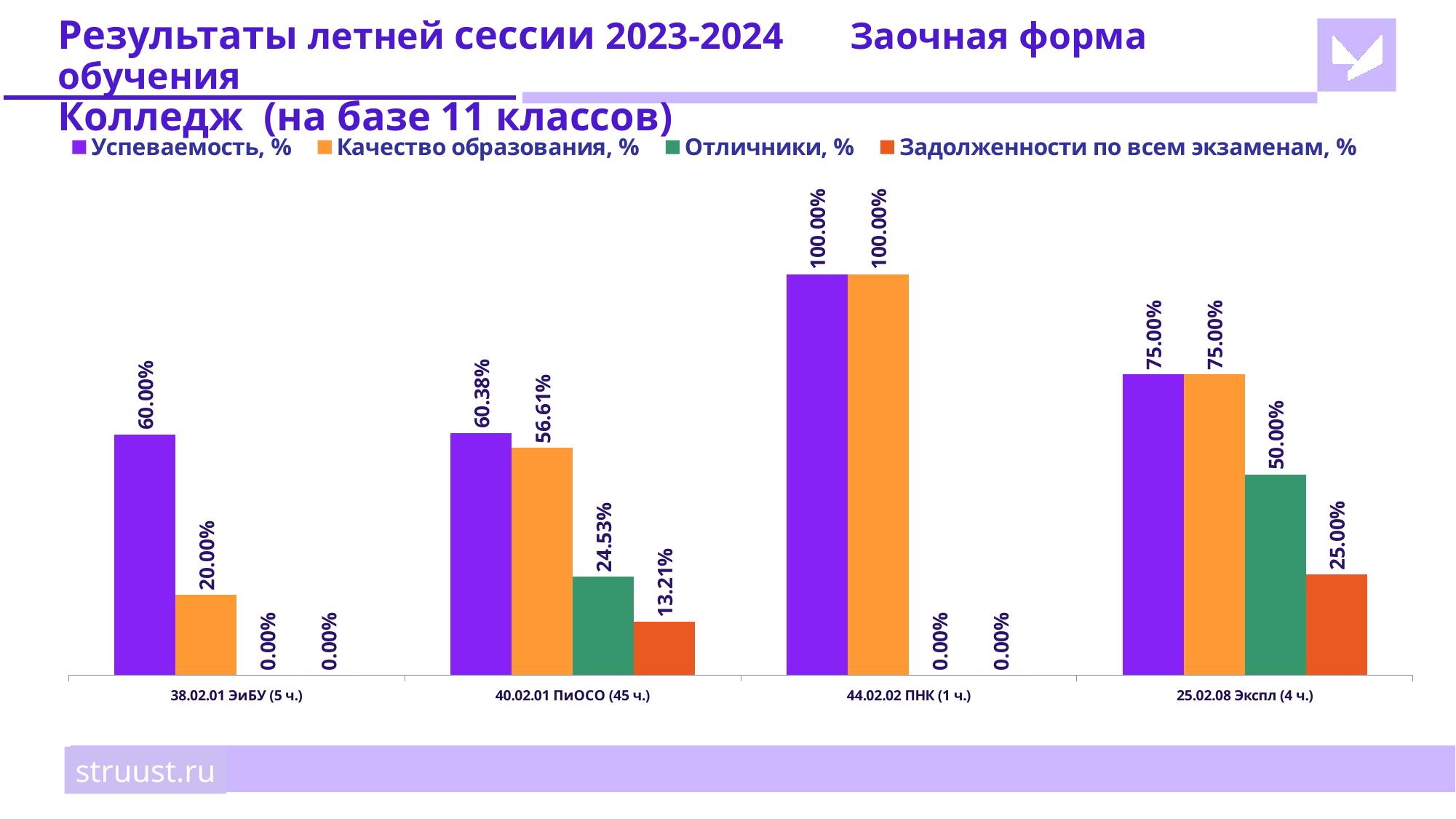
Which colour represents the series Отличники, % in the chart? Green What is the value of Задолженности по всем экзаменам, % for 40.02.01 ПиОСО (45 ч.)? 13.21% How many series does the legend list? 4 What is the value of Отличники, % for 25.02.08 Экспл (4 ч.)? 50.00% Which category has the lowest value of Качество образования, %? 38.02.01 ЭиБУ (5 ч.) What is the value of Успеваемость, % for 40.02.01 ПиОСО (45 ч.)? 60.38% What is the difference between Успеваемость, % and Качество образования, % for 40.02.01 ПиОСО (45 ч.)? 3.77% Which category has the highest value of Успеваемость, %? 44.02.02 ПНК (1 ч.) What kind of chart is shown on the slide? Bar chart How many categories are shown on the x axis of the chart? 4 What is the value of Качество образования, % for 38.02.01 ЭиБУ (5 ч.)? 20.00% Which is larger: Отличники, % for 40.02.01 ПиОСО (45 ч.) or Отличники, % for 25.02.08 Экспл (4 ч.)? 25.02.08 Экспл (4 ч.)